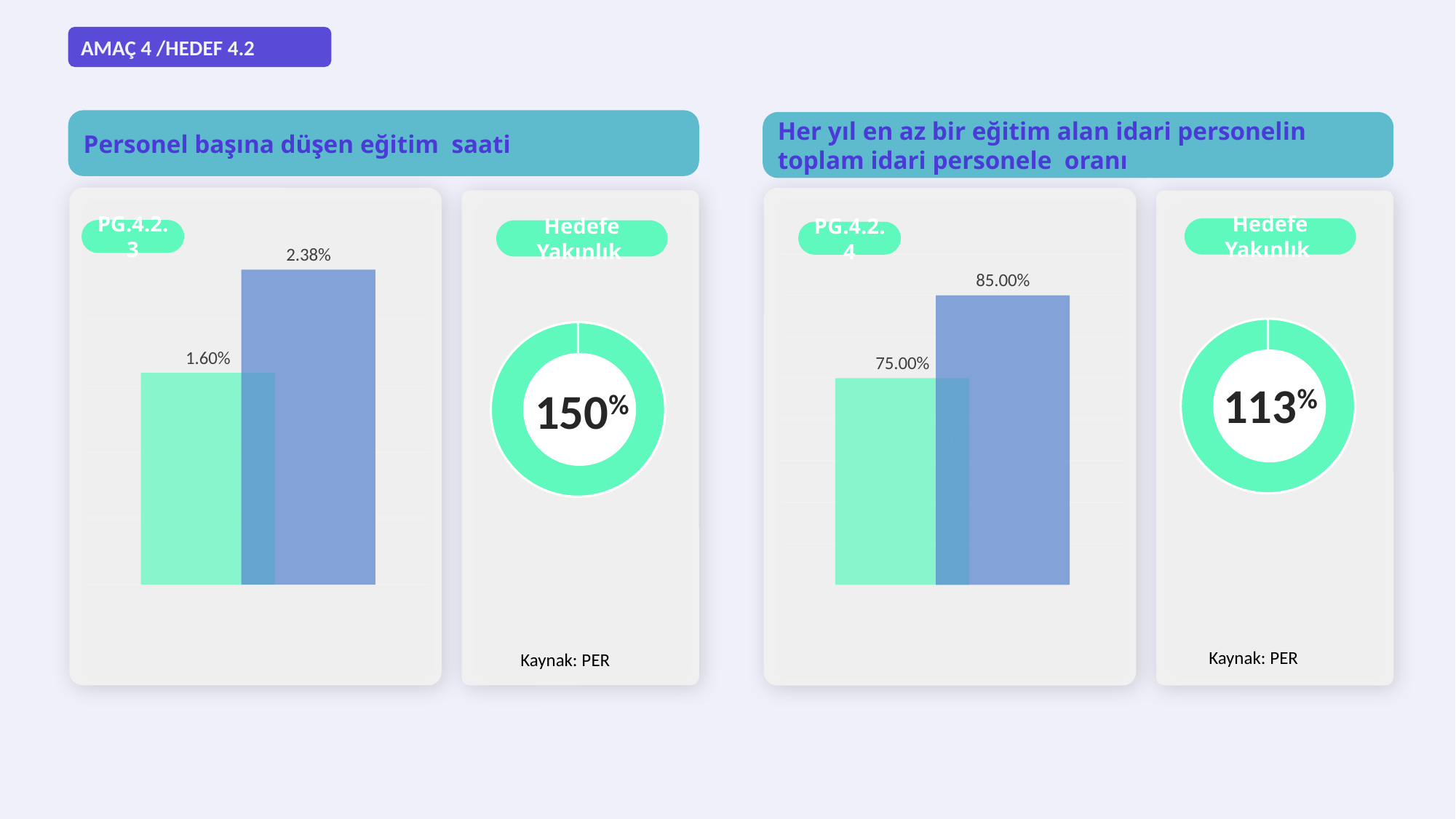
In the 'Personel başına düşen eğitim saati' bar chart, what value is labelled on the green bar? 1.60% In the 'Personel başına düşen eğitim saati' bar chart, which bar is taller, the green one or the blue one? the blue one In the 'Personel başına düşen eğitim saati' bar chart, what is the difference between the blue bar's value and the green bar's value? 0.78% What percentage is shown in the centre of the 'Hedefe Yakınlık' donut chart on the right side of the slide? 113% In the 'Her yıl en az bir eğitim alan idari personelin toplam idari personele oranı' bar chart, what value is labelled on the green bar? 75.00% How many bars are plotted in the 'Personel başına düşen eğitim saati' chart? 2 In the 'Personel başına düşen eğitim saati' bar chart, what value is labelled on the blue bar? 2.38% What source is cited below the 'Hedefe Yakınlık' donut charts? Kaynak: PER What kind of chart is used under the heading 'Personel başına düşen eğitim saati'? bar chart In the 'Her yıl en az bir eğitim alan idari personelin toplam idari personele oranı' bar chart, what is the difference between the blue bar's value and the green bar's value? 10.00% In the 'Her yıl en az bir eğitim alan idari personelin toplam idari personele oranı' bar chart, what value is labelled on the blue bar? 85.00% What percentage is shown in the centre of the 'Hedefe Yakınlık' donut chart next to the 'Personel başına düşen eğitim saati' chart (left side of the slide)? 150%